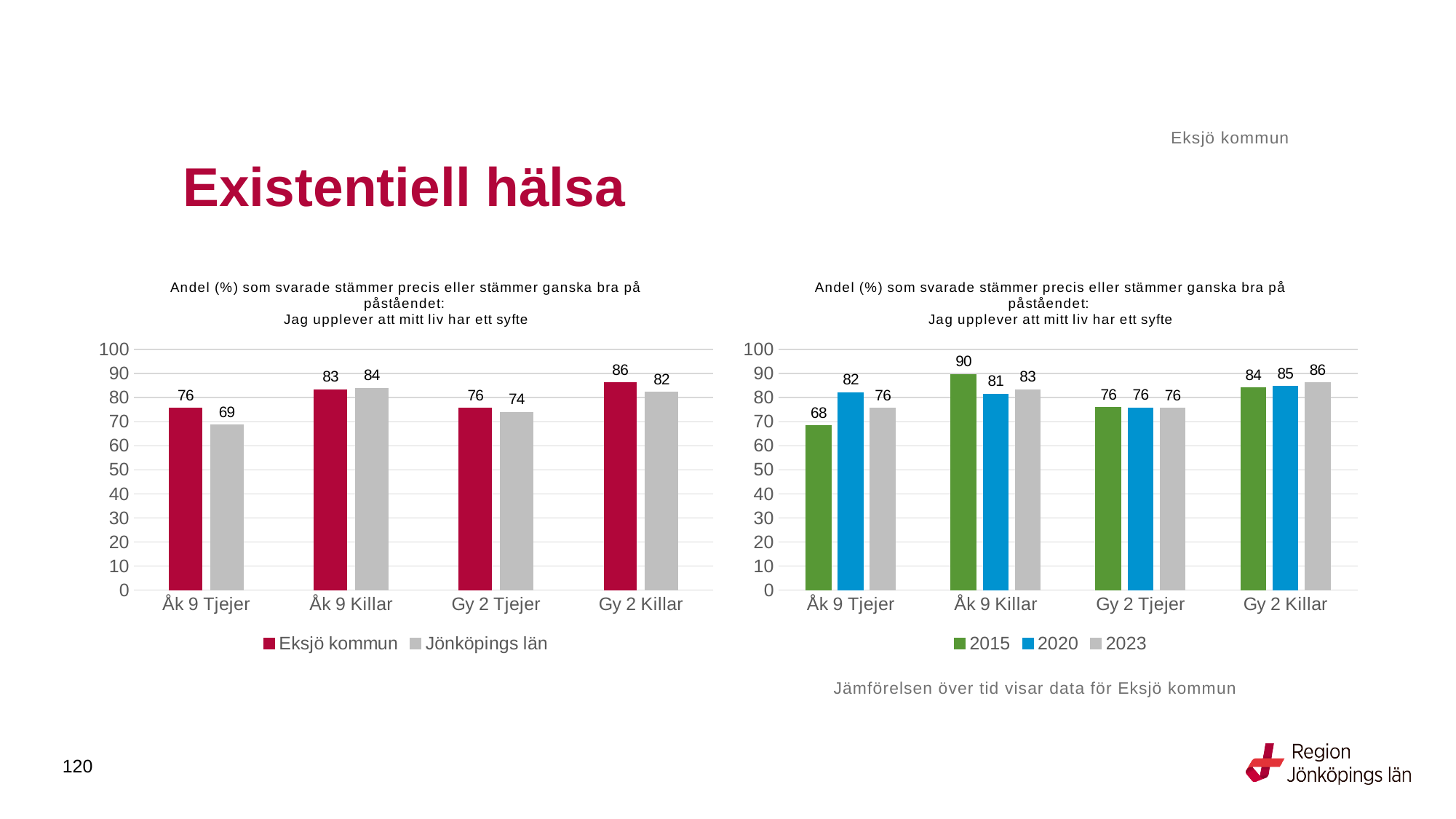
What kind of chart is the right chart? Bar chart In the right chart, what is the value for 2015 for Åk 9 Killar? 90 In the left chart, what is the value for Eksjö kommun for Åk 9 Tjejer? 76 In the left chart, how many series does the legend list? 2 In the right chart, how many series does the legend list? 3 In the left chart, what is the value for Jönköpings län for Gy 2 Killar? 82 In the left chart, which category has the lowest value for Jönköpings län? Åk 9 Tjejer In the left chart, what is the difference between Eksjö kommun and Jönköpings län for Åk 9 Tjejer? 7 In the right chart, which category has the lowest value for 2015? Åk 9 Tjejer In the right chart, is the 2015 value for Åk 9 Killar larger or the 2023 value for Åk 9 Killar? 2015 In the right chart, what is the value for 2020 for Åk 9 Tjejer? 82 In the left chart, which category has the highest value for Eksjö kommun? Gy 2 Killar